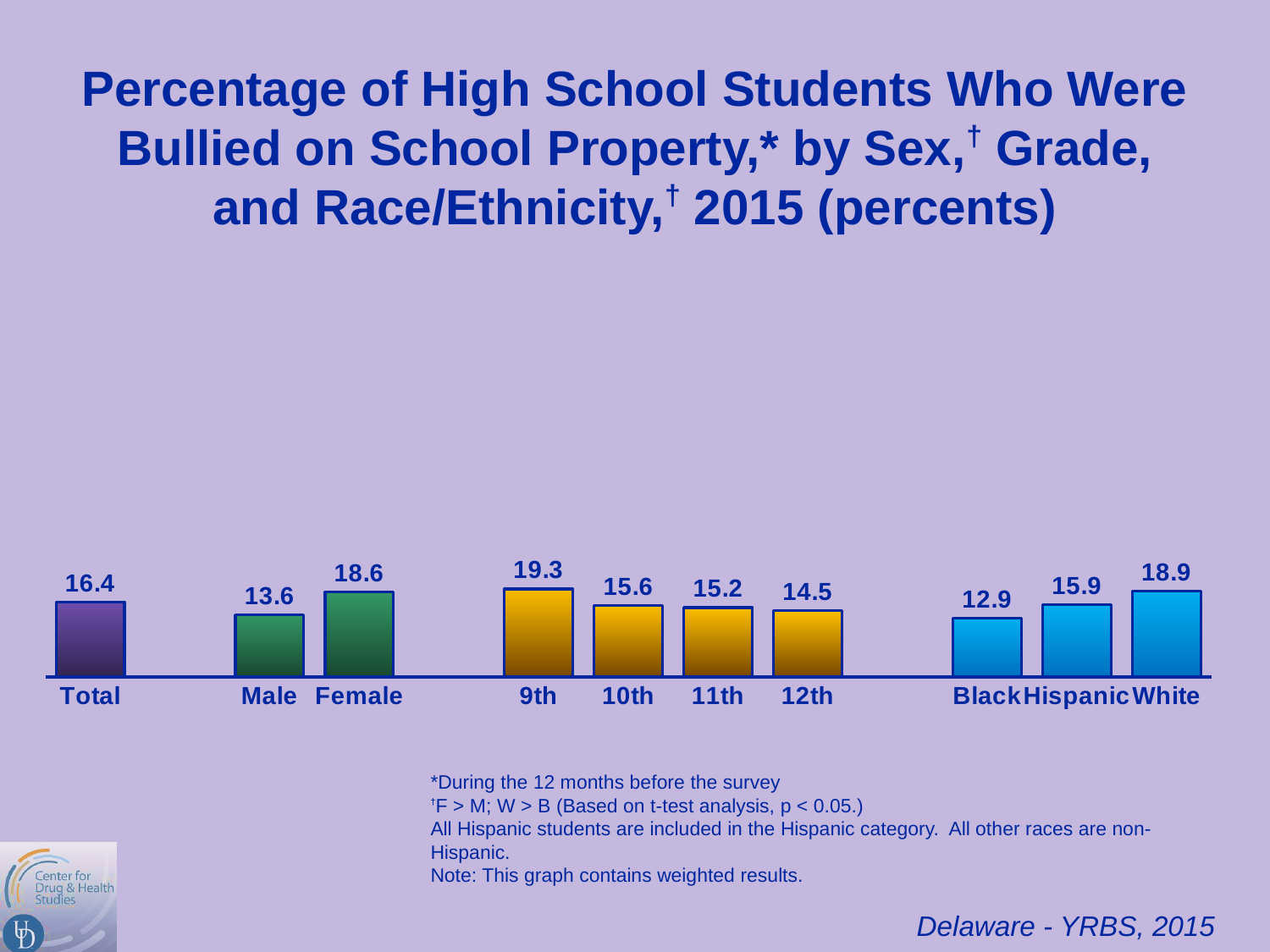
What is the value for 12th grade? 14.5 Do the values rise or fall from 9th grade to 12th grade? fall What is the value for Total? 16.4 What kind of chart is shown on the slide? bar chart What is the difference between the White and Black values? 6.0 How many categories are shown in the chart? 10 What is the difference between the Female and Male values? 5.0 Which category has the lowest value? Black What is the value for Female? 18.6 Which category has the highest value? 9th What is the value for Hispanic? 15.9 Which is larger, the value for 10th grade or 11th grade? 10th